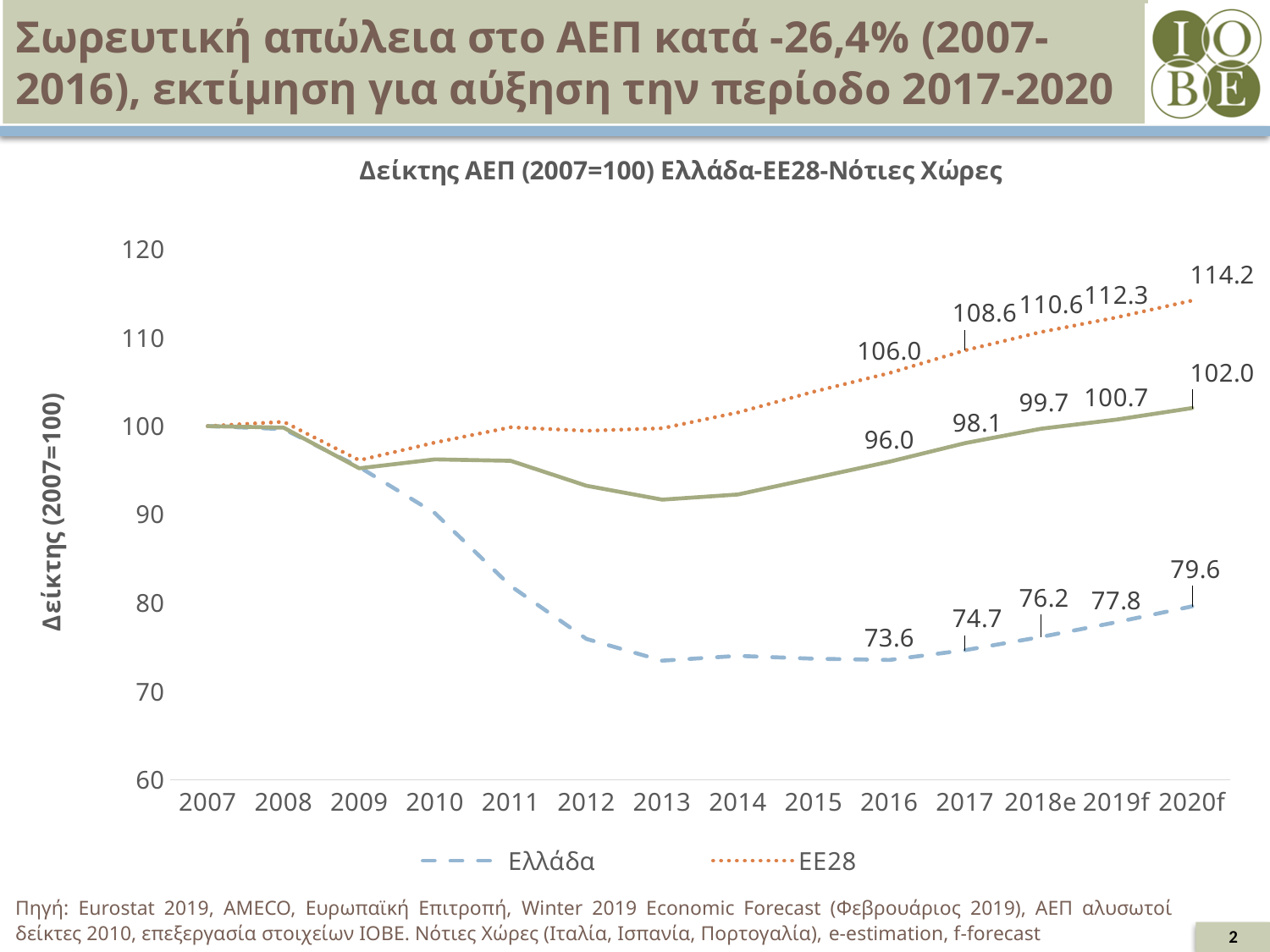
Is the value for Ελλάδα in 2013 greater or less than 80? less By how much does the Ελλάδα value increase from 2016 to 2020f? 6.0 What is the value for ΕΕ28 in 2017? 108.6 What is the value for ΕΕ28 in 2019f? 112.3 What is the value for Ελλάδα in 2020f? 79.6 Is the value for ΕΕ28 in 2009 greater or less than 100? less Which is larger in 2018e, the value for ΕΕ28 or the value for Ελλάδα? ΕΕ28 What kind of chart is shown on the slide? line chart How many years are shown on the x axis? 14 Does the Ελλάδα line rise or fall from 2016 to 2020f? rise What is the difference between the ΕΕ28 value and the Ελλάδα value in 2020f? 34.6 What is the value for Ελλάδα in 2016? 73.6